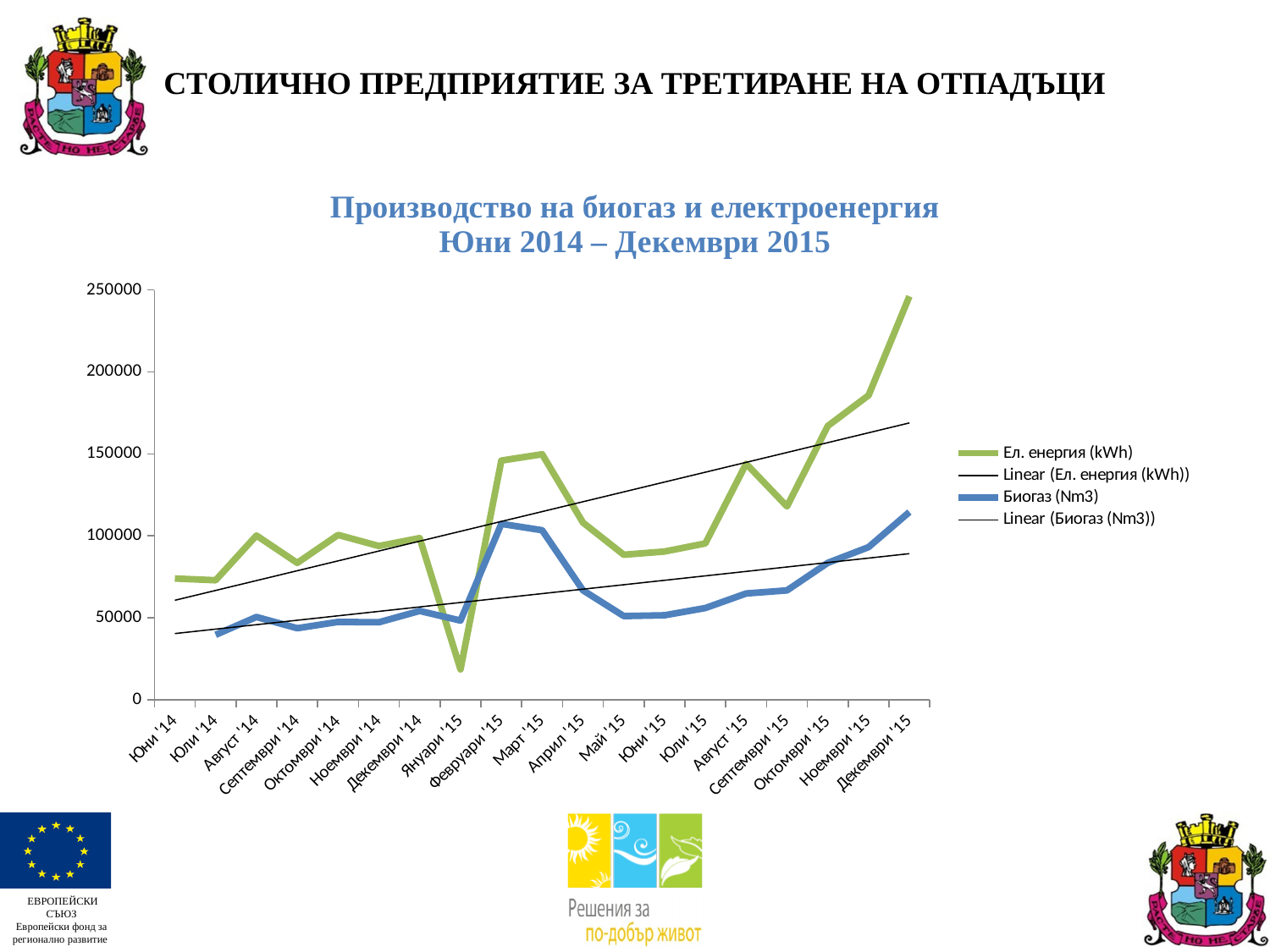
How many months are shown along the x axis of the chart? 19 Which series has the larger value in Януари '15, Ел. енергия (kWh) or Биогаз (Nm3)? Биогаз (Nm3) What kind of chart is shown on the slide? Line chart Is the value for Ел. енергия (kWh) in Януари '15 greater or less than 50000? less In which month is the value for Ел. енергия (kWh) lowest? Януари '15 Is the value for Ел. енергия (kWh) in Декември '15 greater or less than 200000? greater In which month is the value for Биогаз (Nm3) highest? Декември '15 Does the Биогаз (Nm3) series overall rise or fall from Юли '14 to Декември '15? Rise What is the title of the chart? Производство на биогаз и електроенергия Юни 2014 – Декември 2015 Is the value for Биогаз (Nm3) in Декември '15 greater or less than 100000? greater How many entries does the chart legend list? 4 In which month is the value for Ел. енергия (kWh) highest? Декември '15